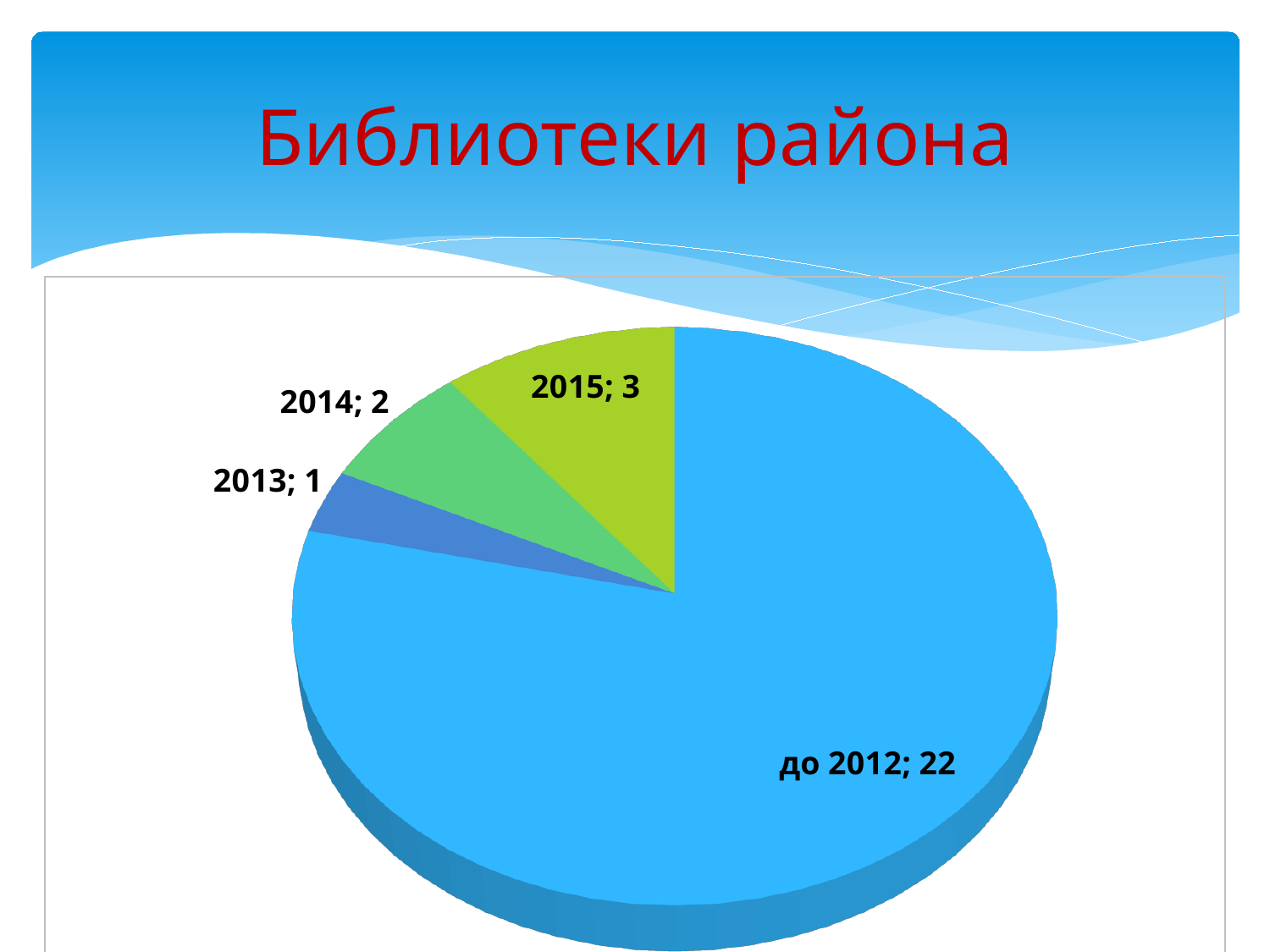
What is the value for the slice labelled "до 2012"? 22 Which slice has the smallest value? 2013 Which is larger, the value for 2014 or the value for 2015? 2015 How many slices does the pie chart have? 4 What is the total of all the slice values in the pie chart? 28 What is the title of the slide containing the chart? Библиотеки района Which slice has the largest value? до 2012 What is the value for the slice labelled "2014"? 2 What is the value for the slice labelled "2013"? 1 What type of chart is shown on the slide? pie chart What is the value for the slice labelled "2015"? 3 What is the difference between the values for "до 2012" and "2015"? 19